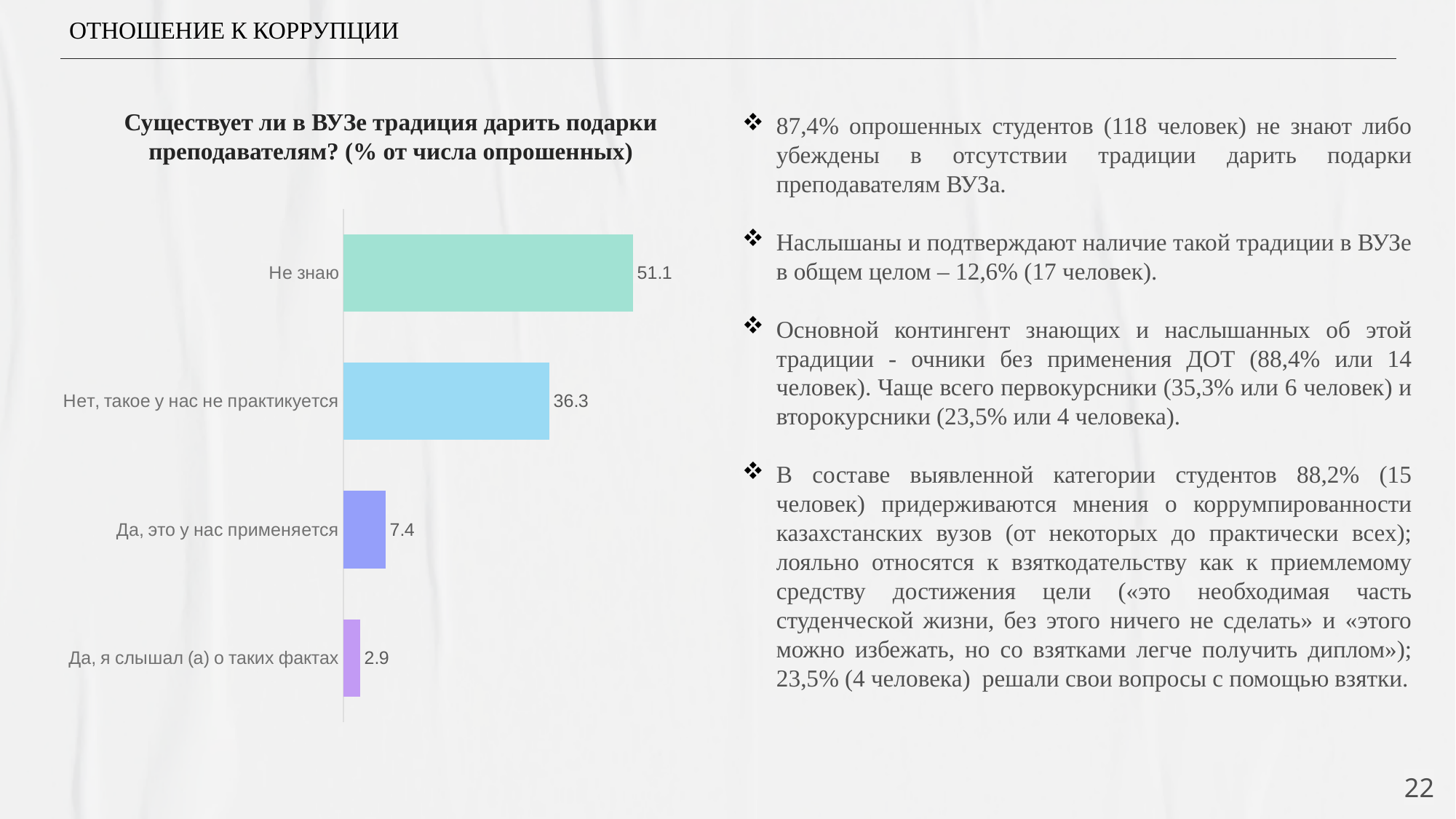
Which category has the highest value? Не знаю What is the value for "Да, это у нас применяется"? 7.4 What kind of chart is shown on the slide? Bar chart What is the difference between the values for "Да, это у нас применяется" and "Да, я слышал (а) о таких фактах"? 4.5 What is the value for "Нет, такое у нас не практикуется"? 36.3 What is the value for "Не знаю"? 51.1 Which category has the lowest value? Да, я слышал (а) о таких фактах What is the difference between the values for "Не знаю" and "Нет, такое у нас не практикуется"? 14.8 What is the value for "Да, я слышал (а) о таких фактах"? 2.9 How many categories are shown in the chart? 4 What is the title of the chart? Существует ли в ВУЗе традиция дарить подарки преподавателям? (% от числа опрошенных) Which is larger: the value for "Нет, такое у нас не практикуется" or for "Да, это у нас применяется"? Нет, такое у нас не практикуется